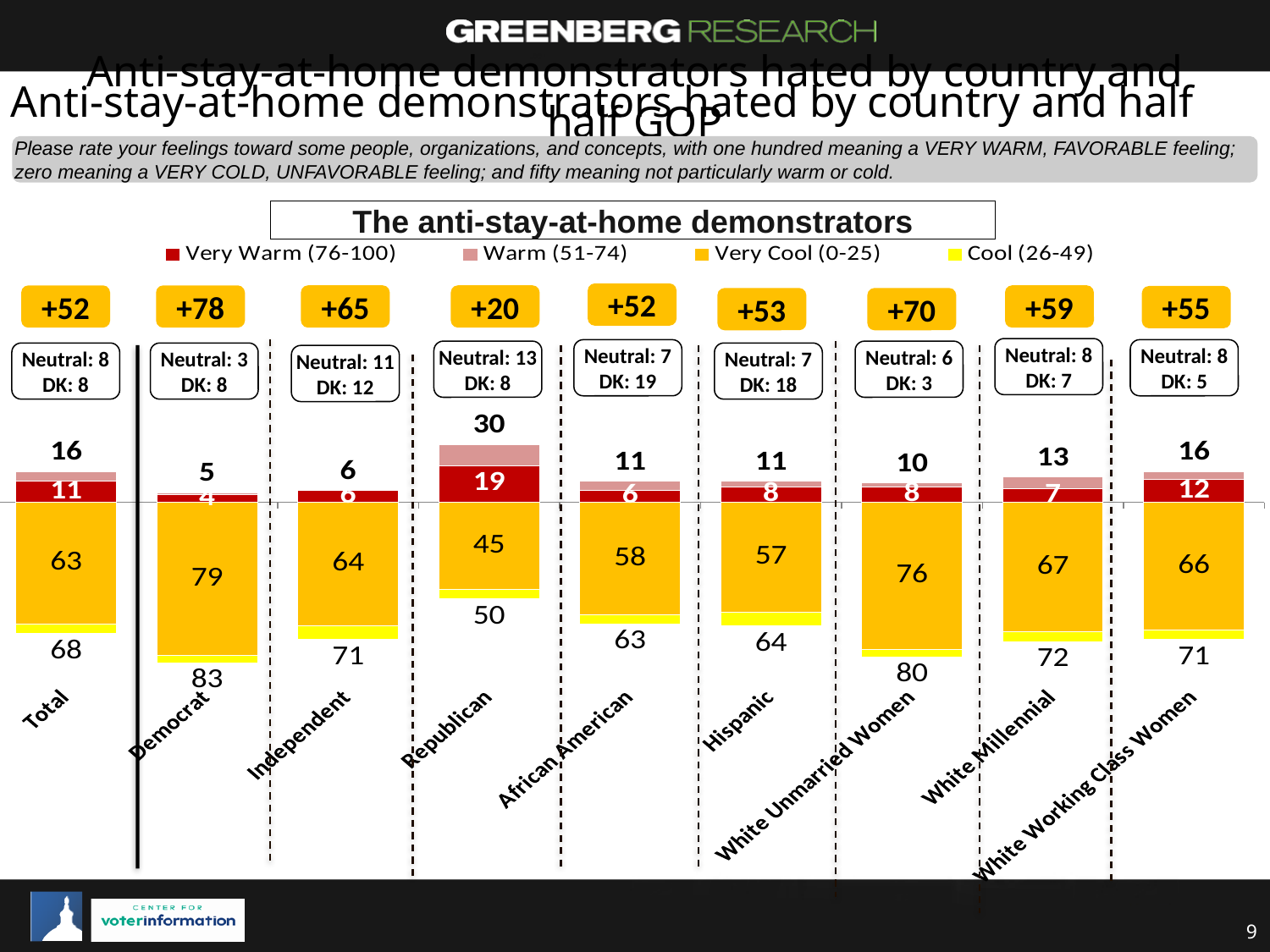
What is the total warm value shown above the bar for White Millennial? 13 What type of chart is shown on the slide? bar chart How many series does the legend list? 4 Which category has the highest net score shown in the orange boxes? Democrat (+78) What is the title of the chart? The anti-stay-at-home demonstrators What is the Very Warm (76-100) value for Republican? 19 What is the difference between the total cool value for Democrat (83) and for Republican (50)? 33 How many categories are shown along the x axis? 9 Which category has the lowest Very Cool (0-25) value? Republican What is the Very Cool (0-25) value for Democrat? 79 Which category has the highest Very Cool (0-25) value? Democrat Which is larger, the Very Cool (0-25) value for White Unmarried Women or for White Millennial? White Unmarried Women